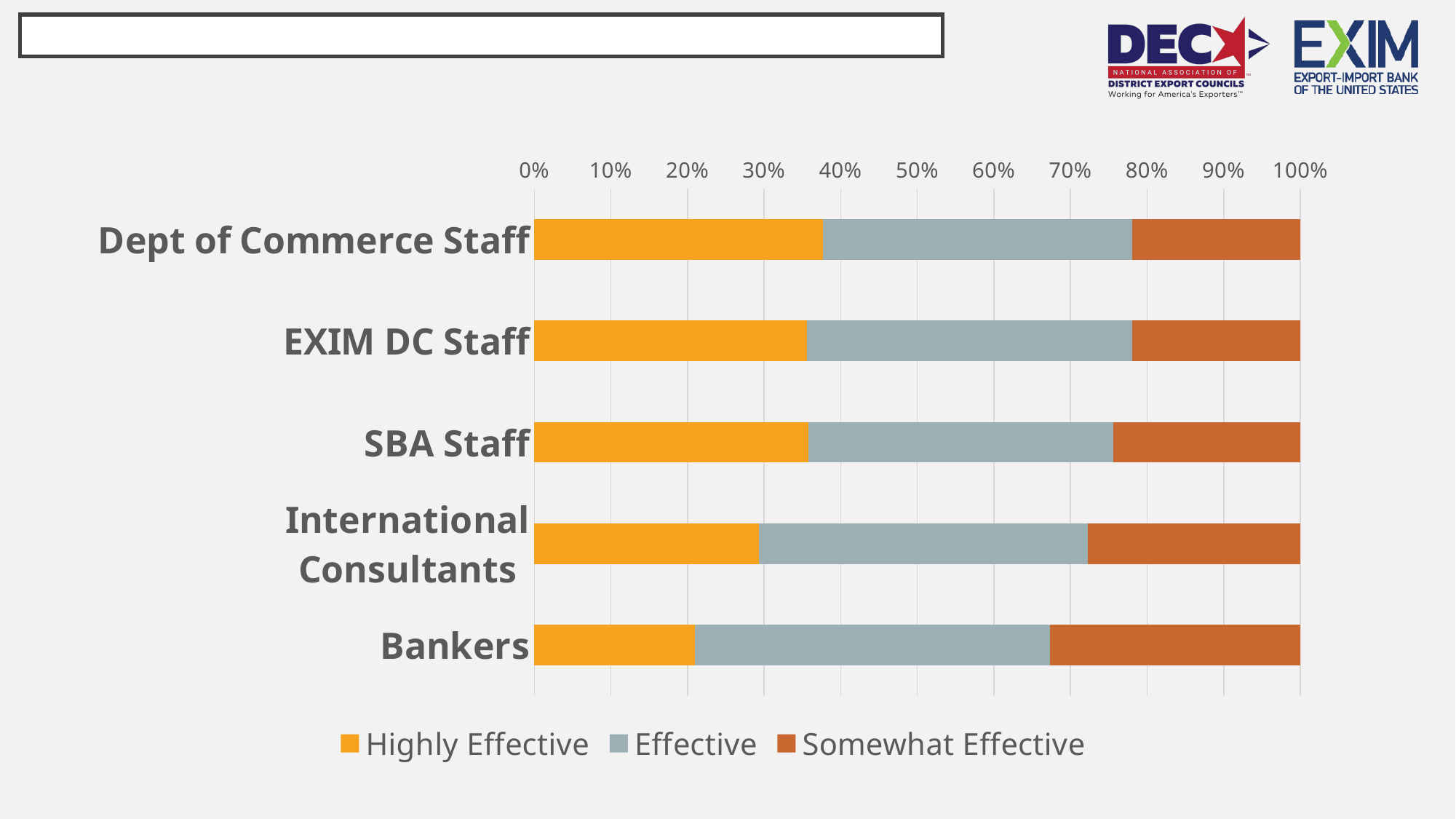
What is the total of the stacked bar for SBA Staff? 100% Is the Highly Effective value for Bankers greater or less than 30%? less Is the Highly Effective value for Dept of Commerce Staff greater or less than 30%? greater How many categories are shown on the vertical axis of the chart? 5 Is the Highly Effective value for International Consultants greater or less than 20%? greater What kind of chart is shown on the slide? Stacked bar chart Which has a larger Highly Effective share, Dept of Commerce Staff or Bankers? Dept of Commerce Staff Which has a larger Somewhat Effective share, International Consultants or EXIM DC Staff? International Consultants Which category has the smallest Highly Effective segment? Bankers Which category has the largest Somewhat Effective segment? Bankers How many series does the legend list? 3 Which colour represents the Effective series in the legend? Grey-blue